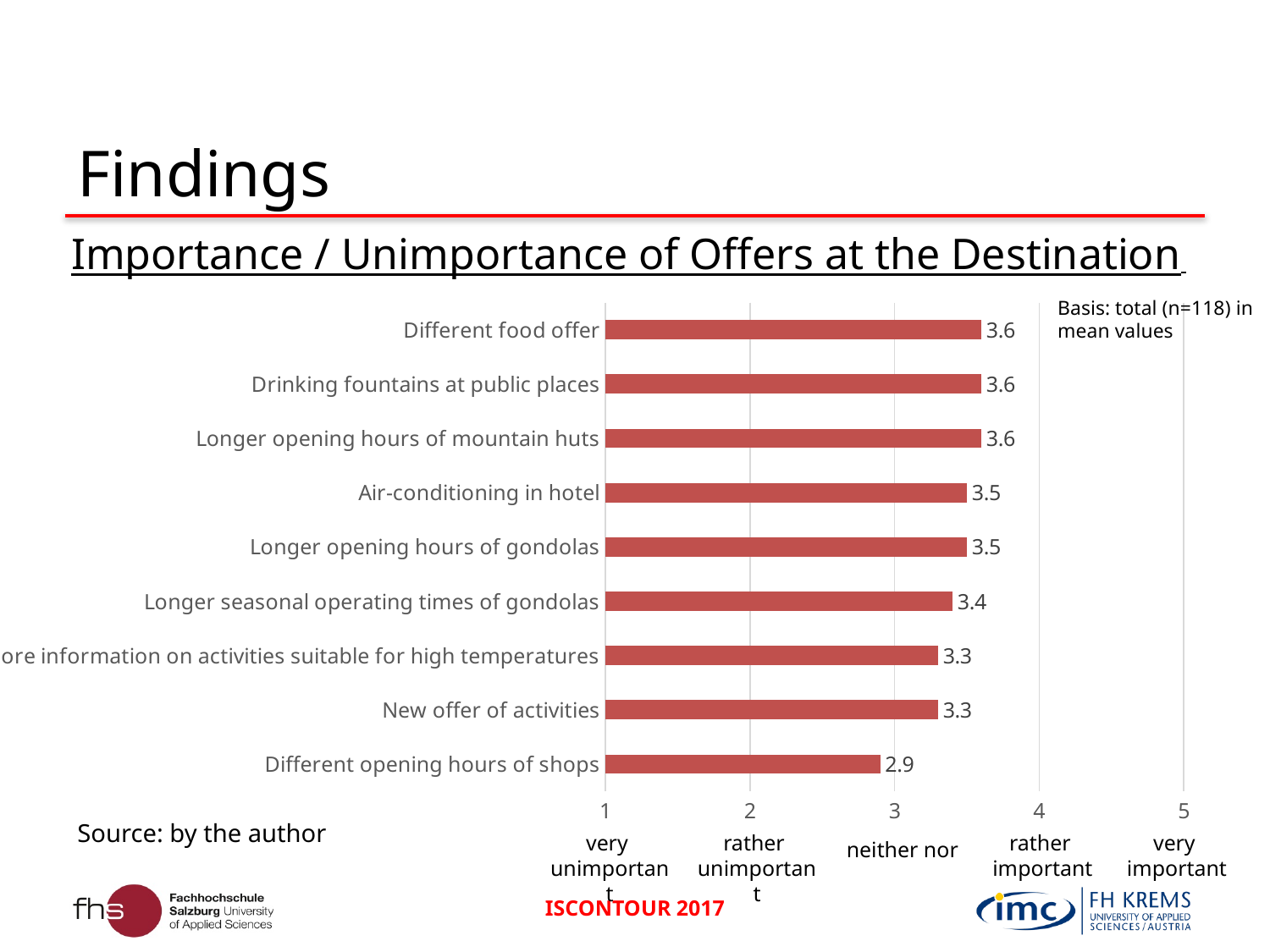
What kind of chart is shown on the slide? bar chart What is the mean value for Different opening hours of shops? 2.9 What is the mean value for Air-conditioning in hotel? 3.5 What is the mean value for Different food offer? 3.6 Which offer has the lowest mean value? Different opening hours of shops What is the mean value for Longer seasonal operating times of gondolas? 3.4 What is the sample size (n) stated for the chart? 118 Which has a higher mean value, Longer opening hours of mountain huts or New offer of activities? Longer opening hours of mountain huts Is the value for Different opening hours of shops greater or less than 3? less What is the mean value for New offer of activities? 3.3 How many offers are shown in the chart? 9 What is the difference between the mean values for Drinking fountains at public places and Different opening hours of shops? 0.7